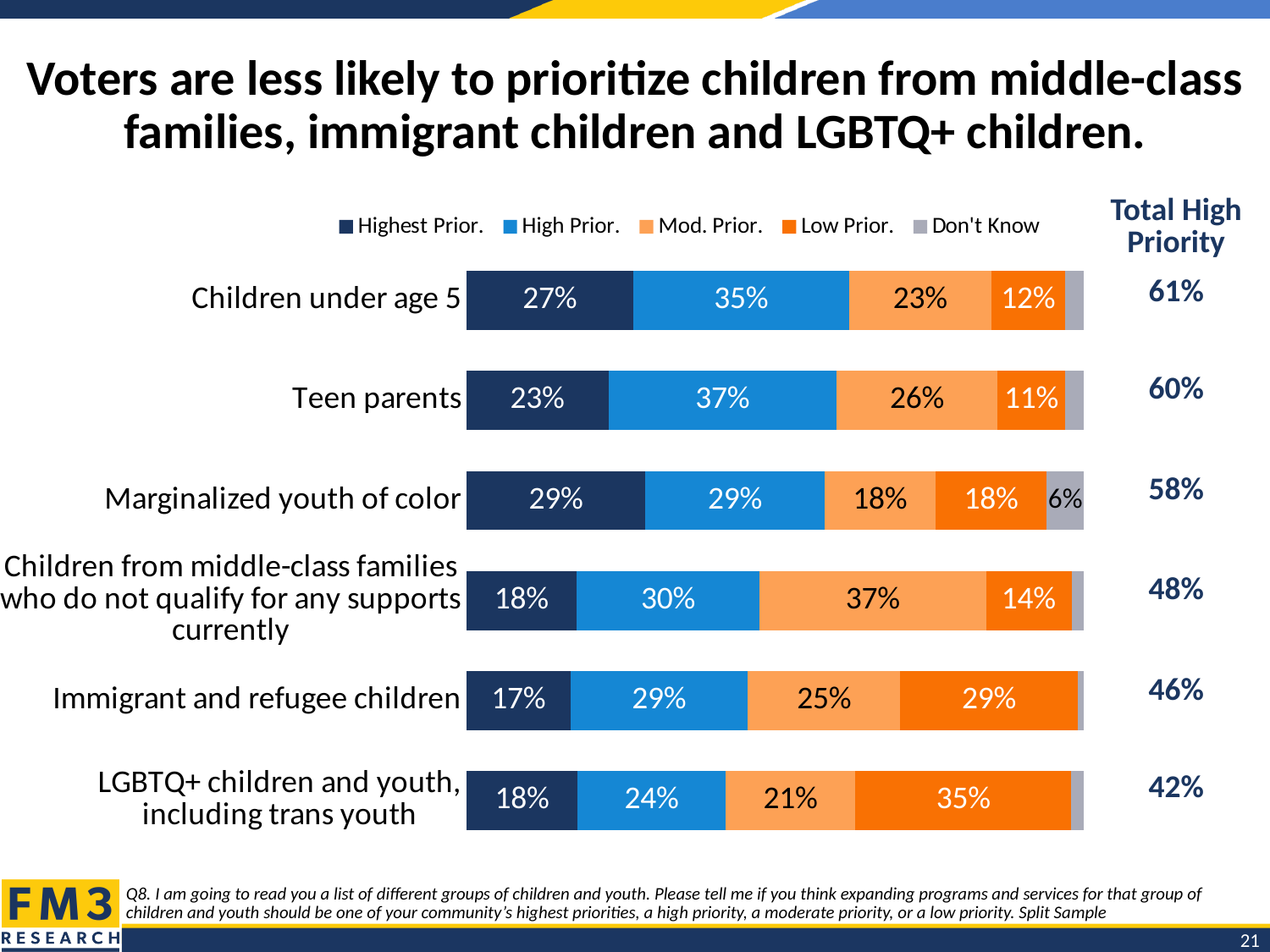
Which category has the highest Total High Priority figure? Children under age 5 What kind of chart is shown on the slide? Stacked bar chart What percentage of voters rated "Children under age 5" as Highest Prior.? 27% What is the Low Prior. value for "LGBTQ+ children and youth, including trans youth"? 35% What is the Total High Priority figure shown for "Teen parents"? 60% What is the Mod. Prior. value for "Children from middle-class families who do not qualify for any supports currently"? 37% Which has a larger High Prior. value: "Teen parents" or "Marginalized youth of color"? Teen parents How many series does the legend list? 5 What is the Don't Know value for "Marginalized youth of color"? 6% Which category has the lowest Total High Priority figure? LGBTQ+ children and youth, including trans youth How many categories (groups of children and youth) are shown in the chart? 6 What is the difference between the Low Prior. values for "Immigrant and refugee children" and "Children under age 5"? 17%